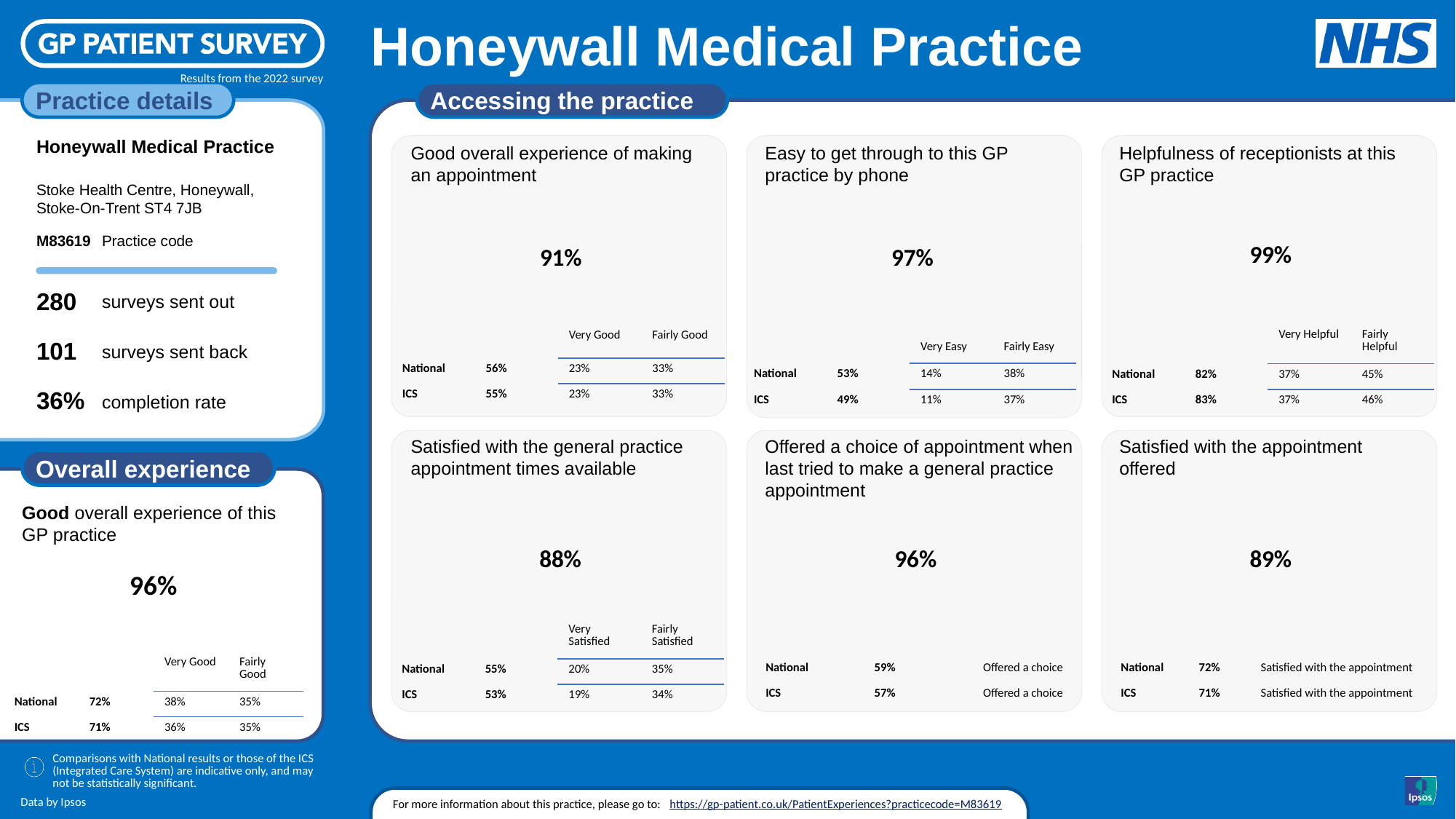
In the 'Good overall experience of this GP practice' panel, what are the two response categories listed in the comparison table? Very Good and Fairly Good In the 'Offered a choice of appointment' panel, which is larger: the National figure or the ICS figure? National In the 'Good overall experience of making an appointment' panel, what is the ICS 'Fairly Good' percentage? 33% In the 'Easy to get through to this GP practice by phone' panel, what is the difference between the practice's headline percentage and the National figure? 44 percentage points In the 'Helpfulness of receptionists at this GP practice' panel, what is the National figure? 82% In the 'Good overall experience of this GP practice' panel, what is the practice's headline percentage? 96% Among the six 'Accessing the practice' panels, which has the lowest headline percentage? Satisfied with the general practice appointment times available How many panels are shown under the 'Accessing the practice' heading? 6 In the 'Satisfied with the general practice appointment times available' panel, what is the National 'Very Satisfied' percentage? 20% Among the six 'Accessing the practice' panels, which has the highest headline percentage? Helpfulness of receptionists at this GP practice In the 'Satisfied with the appointment offered' panel, what is the difference between the National and ICS figures? 1 percentage point In the 'Easy to get through to this GP practice by phone' panel, what is the practice's headline percentage? 97%